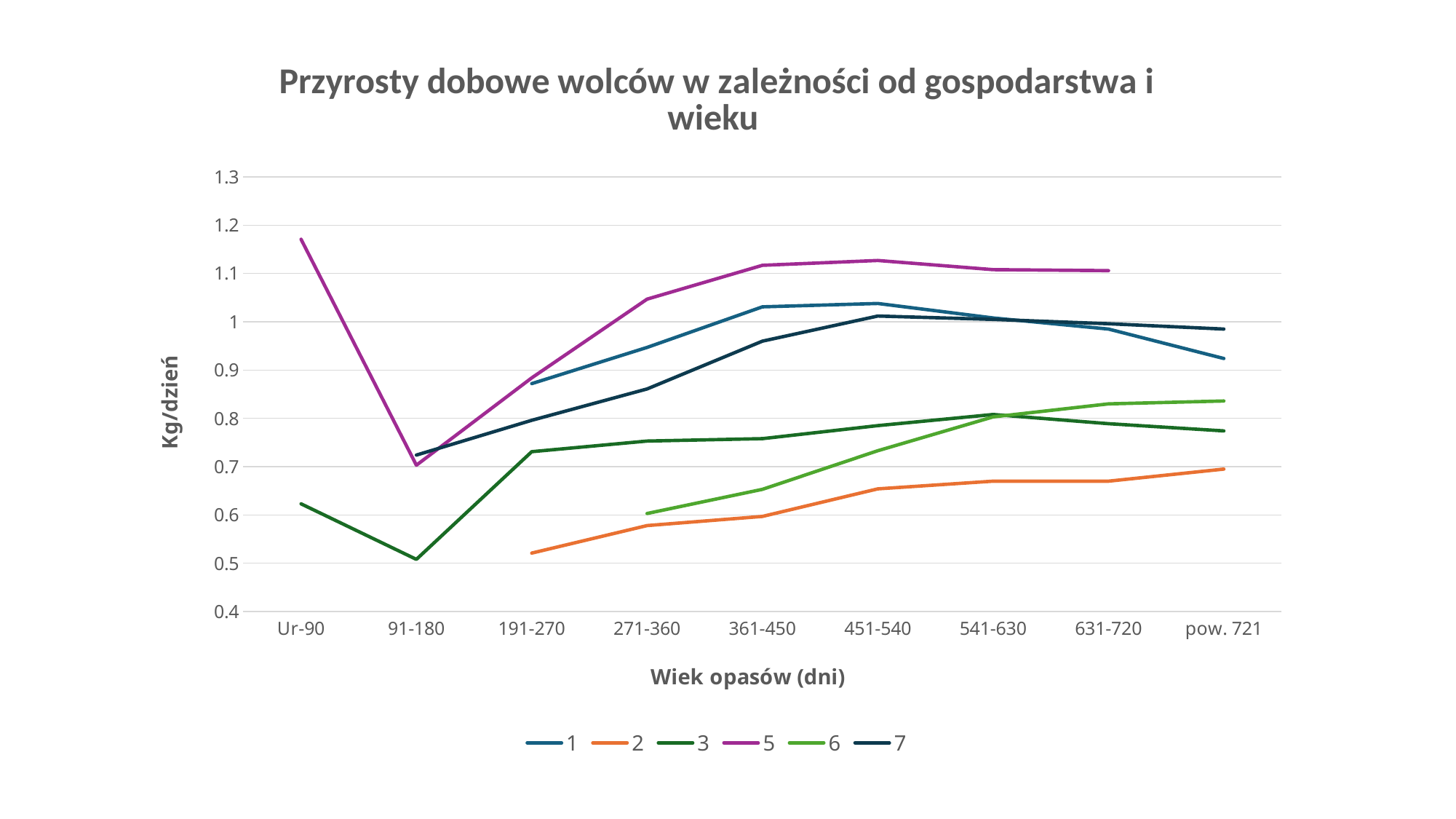
What is the label of the y axis? Kg/dzień Does series 6 rise or fall from 271-360 to pow. 721? rise Is the value for series 3 at 91-180 greater or less than 0.6? less At 361-450, which series has the larger value, series 5 or series 1? 5 Is the value for series 2 at 631-720 greater or less than 0.7? less Is the value for series 1 at 451-540 greater or less than 1? greater How many series does the legend list? 6 Which series has the highest value at Ur-90? 5 How many age categories are shown on the x axis? 9 Which series has the lowest value at pow. 721? 2 What kind of chart is shown on the slide? line chart